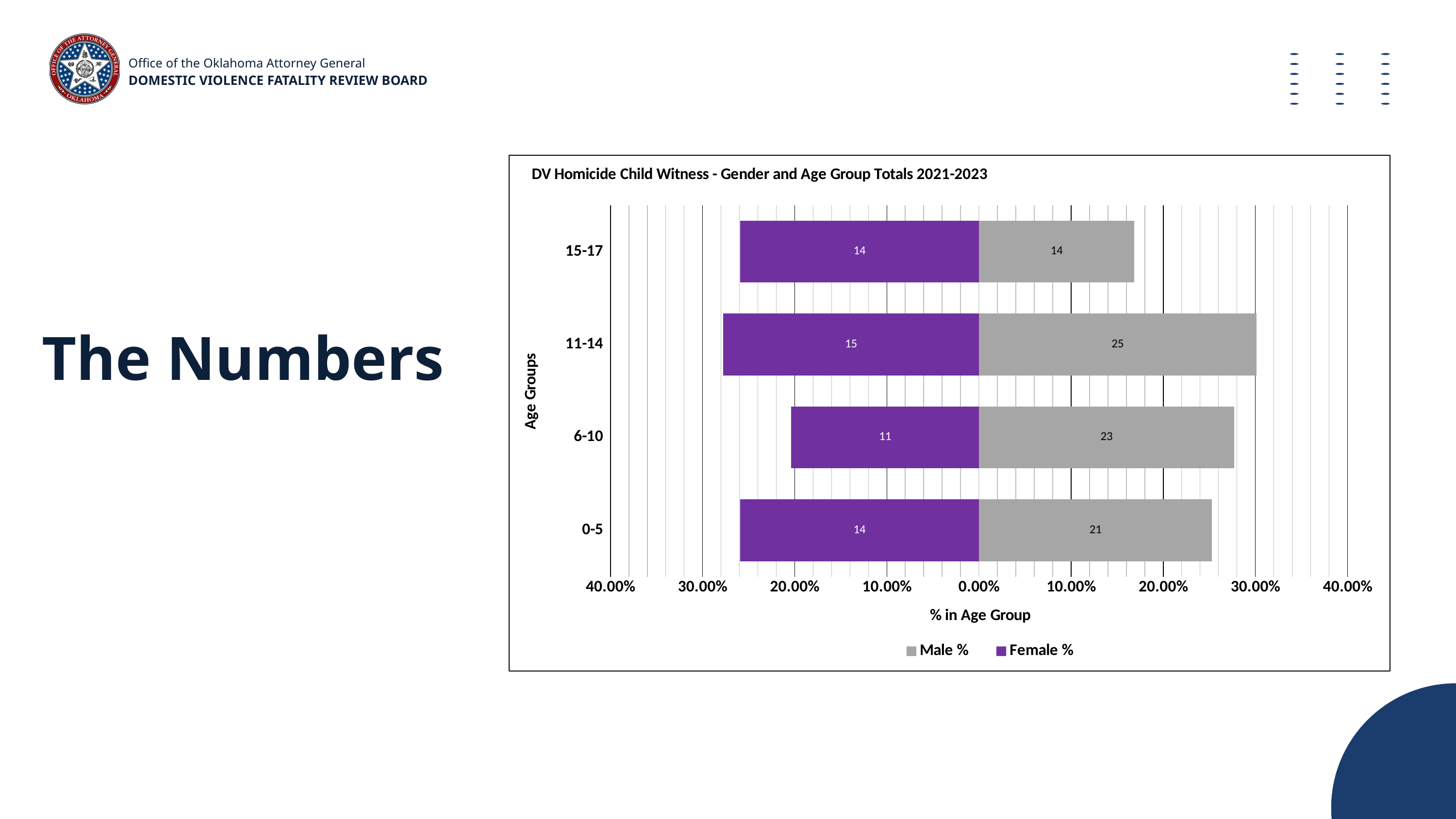
How many age groups are shown on the chart? 4 How many series does the legend list? 2 What is the difference between the Male % and Female % data labels for the 6-10 age group? 12 What is the data label on the Male % bar for the 0-5 age group? 21 What is the data label on the Male % bar for the 11-14 age group? 25 Is the Male % bar for the 15-17 age group greater or less than 20.00%? less What is the data label on the Female % bar for the 15-17 age group? 14 Which age group has the lowest Female % data label? 6-10 What is the data label on the Female % bar for the 6-10 age group? 11 What kind of chart is shown on the slide? Bar chart Which age group has the highest Male % data label? 11-14